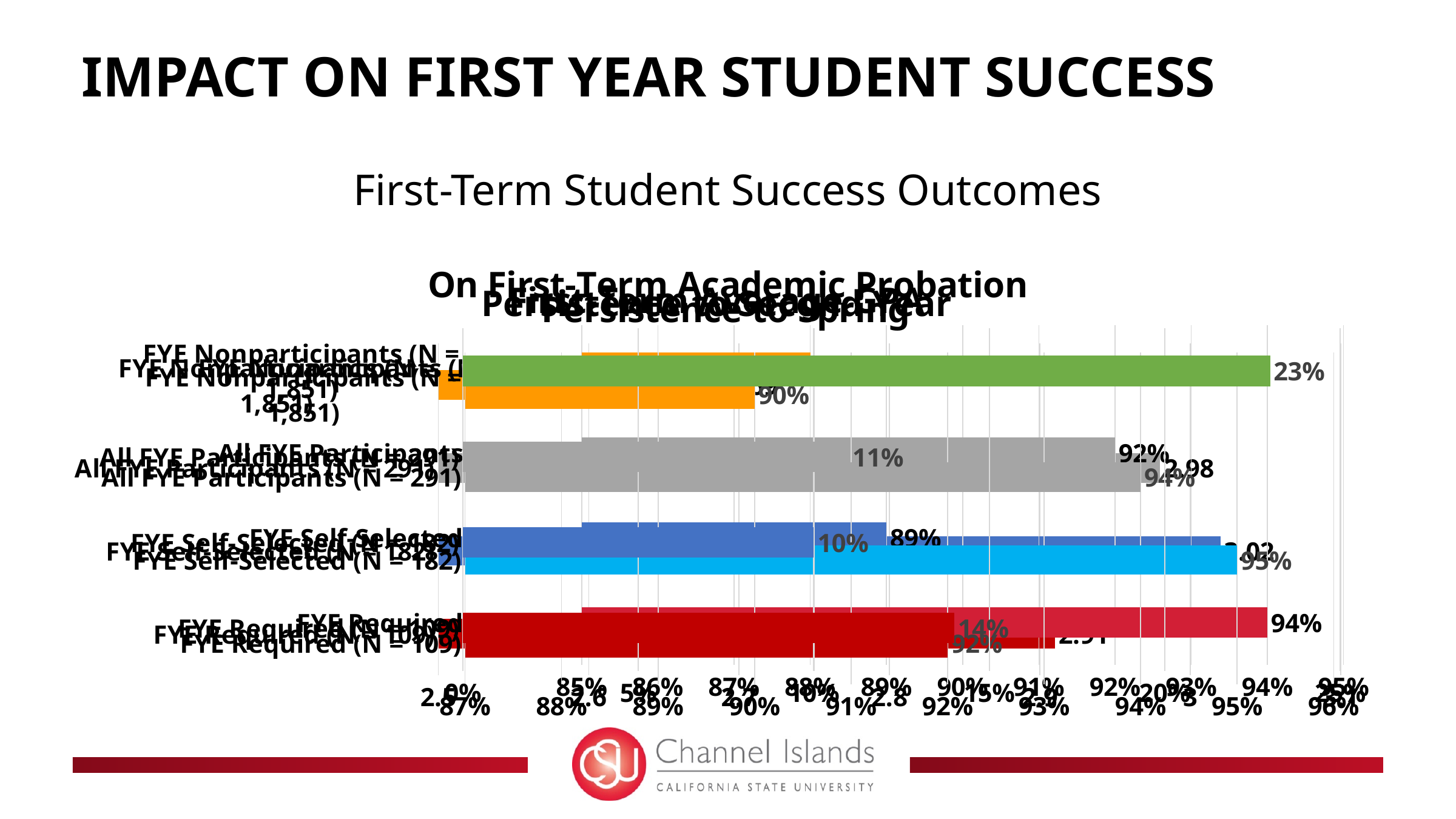
In the 'On First-Term Academic Probation' chart, what percentage is shown for FYE Required? 14% What is the N (sample size) shown for the FYE Required group? 109 In the 'On First-Term Academic Probation' chart, what percentage is shown for All FYE Participants? 11% In the 'On First-Term Academic Probation' chart, what percentage is shown for FYE Self-Selected? 10% In the 'On First-Term Academic Probation' chart, which is higher: FYE Required or All FYE Participants? FYE Required What is the N (sample size) shown for the FYE Nonparticipants group? 1,851 In the 'On First-Term Academic Probation' chart, which group has the lowest percentage on probation? FYE Self-Selected In the 'On First-Term Academic Probation' chart, which group has the highest percentage on probation? FYE Nonparticipants What type of chart is used on this slide? Bar chart In the 'On First-Term Academic Probation' chart, what percentage is shown for FYE Nonparticipants? 23% How many student groups (categories) are listed on the vertical axis of the charts? 4 In the 'On First-Term Academic Probation' chart, what is the difference in percentage points between FYE Nonparticipants and FYE Required? 9 percentage points